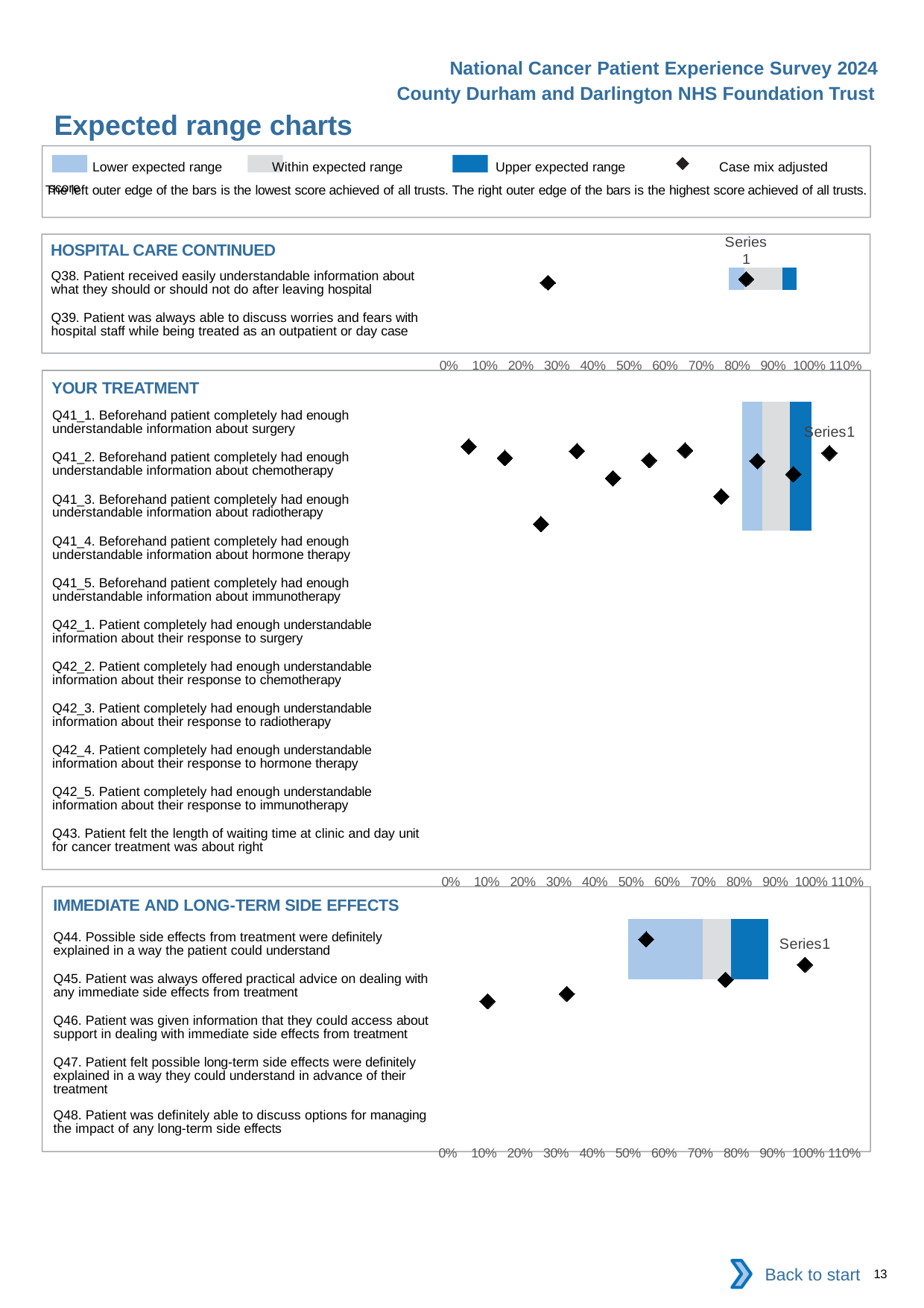
In the IMMEDIATE AND LONG-TERM SIDE EFFECTS chart, what is the highest percentage tick shown on the x axis? 110% In the IMMEDIATE AND LONG-TERM SIDE EFFECTS chart, how many questions (categories) are listed? 5 How many entries does the legend at the top of the slide list? 4 In the YOUR TREATMENT chart, how many questions (categories) are listed? 11 In the HOSPITAL CARE CONTINUED chart, how many questions (categories) are listed? 2 According to the legend, what does the black diamond marker represent? Case mix adjusted score What is the title of the slide? Expected range charts In the YOUR TREATMENT chart, what is the lowest percentage tick shown on the x axis? 0%